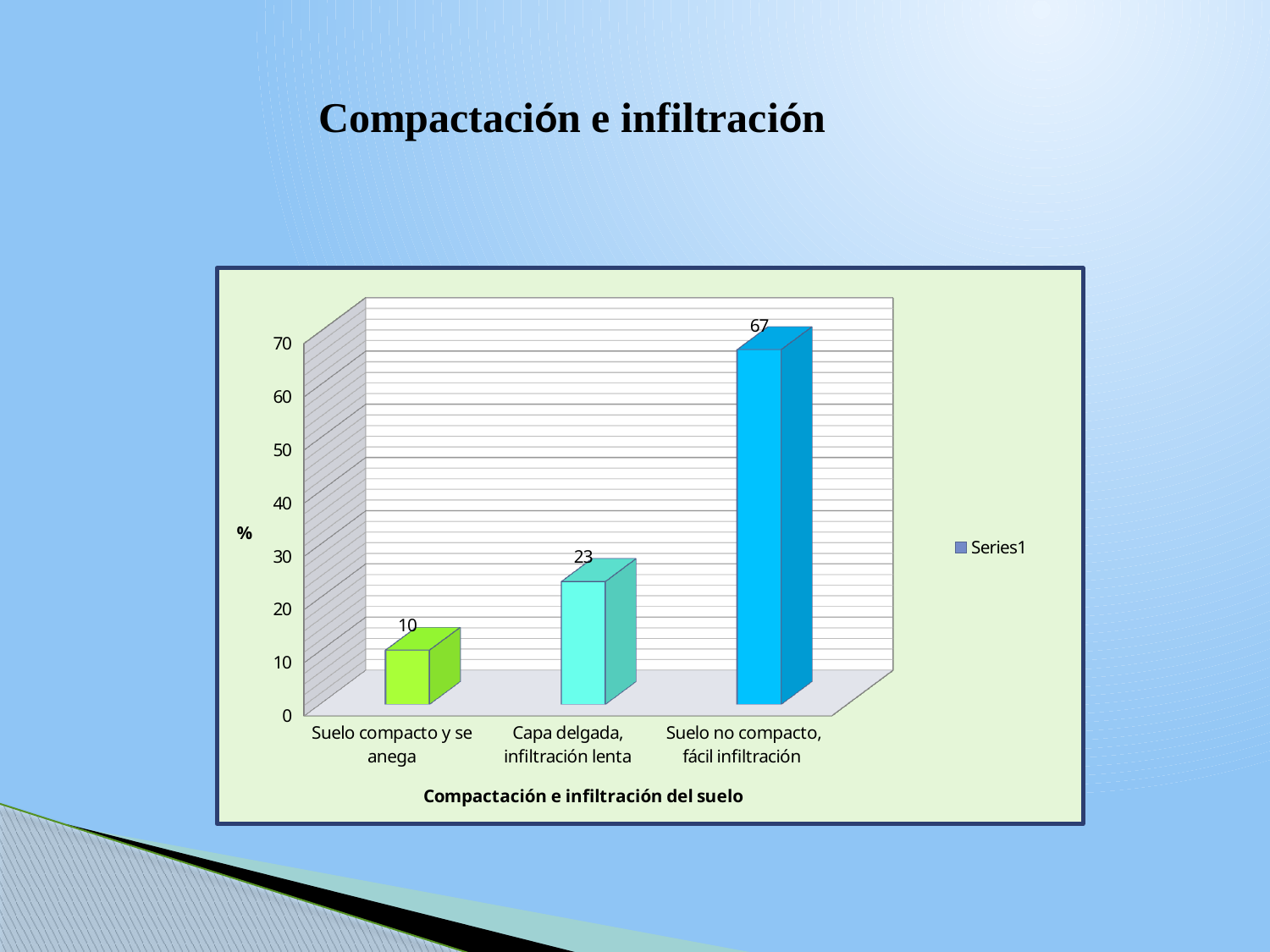
What is the x-axis title of the chart? Compactación e infiltración del suelo Which is larger, the value for "Capa delgada, infiltración lenta" or "Suelo compacto y se anega"? Capa delgada, infiltración lenta What is the value for "Suelo compacto y se anega"? 10 What is the difference between the values for "Capa delgada, infiltración lenta" and "Suelo compacto y se anega"? 13 How many series does the legend list? 1 What is the difference between the values for "Suelo no compacto, fácil infiltración" and "Capa delgada, infiltración lenta"? 44 What is the value for "Capa delgada, infiltración lenta"? 23 What kind of chart is shown? Bar chart What is the value for "Suelo no compacto, fácil infiltración"? 67 Which category has the lowest value? Suelo compacto y se anega Which category has the highest value? Suelo no compacto, fácil infiltración How many categories are shown on the x axis? 3